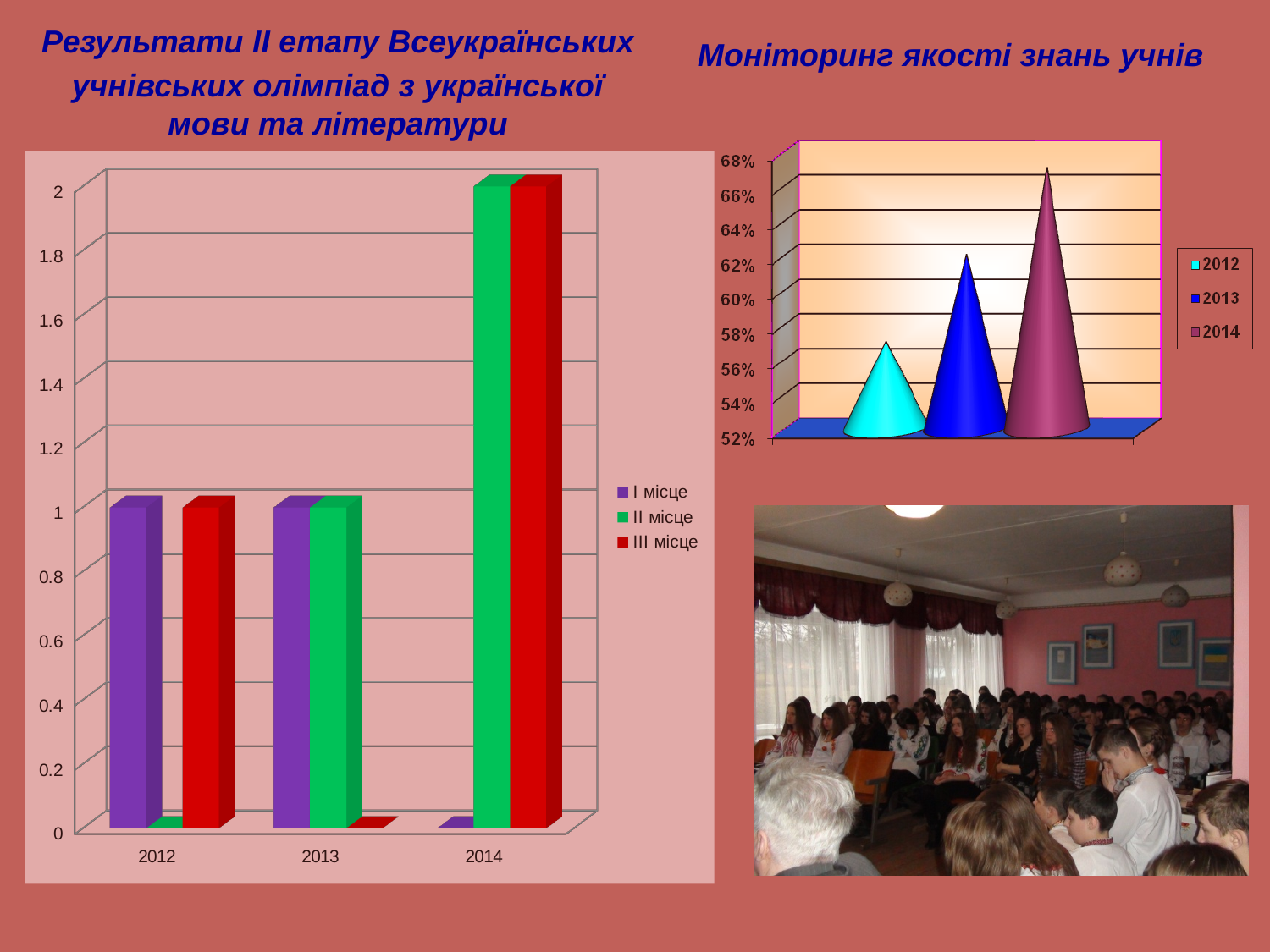
On the left chart (Результати ІІ етапу Всеукраїнських учнівських олімпіад), how many series does the legend list? 3 On the left chart (Результати ІІ етапу Всеукраїнських учнівських олімпіад), in which year is the value for ІІІ місце highest? 2014 On the right chart (Моніторинг якості знань учнів), do the values rise or fall from 2012 to 2014? rise On the left chart (Результати ІІ етапу Всеукраїнських учнівських олімпіад), what is the difference between the ІІ місце values for 2014 and 2013? 1 On the left chart (Результати ІІ етапу Всеукраїнських учнівських олімпіад), how many years are shown on the x axis? 3 On the left chart (Результати ІІ етапу Всеукраїнських учнівських олімпіад), what is the value for І місце in 2012? 1 On the left chart (Результати ІІ етапу Всеукраїнських учнівських олімпіад), what is the value for ІІІ місце in 2013? 0 On the right chart (Моніторинг якості знань учнів), is the value for 2012 greater or less than 60%? less On the right chart (Моніторинг якості знань учнів), is the value for 2014 greater or less than 64%? greater On the left chart (Результати ІІ етапу Всеукраїнських учнівських олімпіад), which is larger in 2012: І місце or ІІ місце? І місце On the left chart (Результати ІІ етапу Всеукраїнських учнівських олімпіад), what is the value for ІІ місце in 2014? 2 What kind of chart is the left chart (Результати ІІ етапу Всеукраїнських учнівських олімпіад)? bar chart